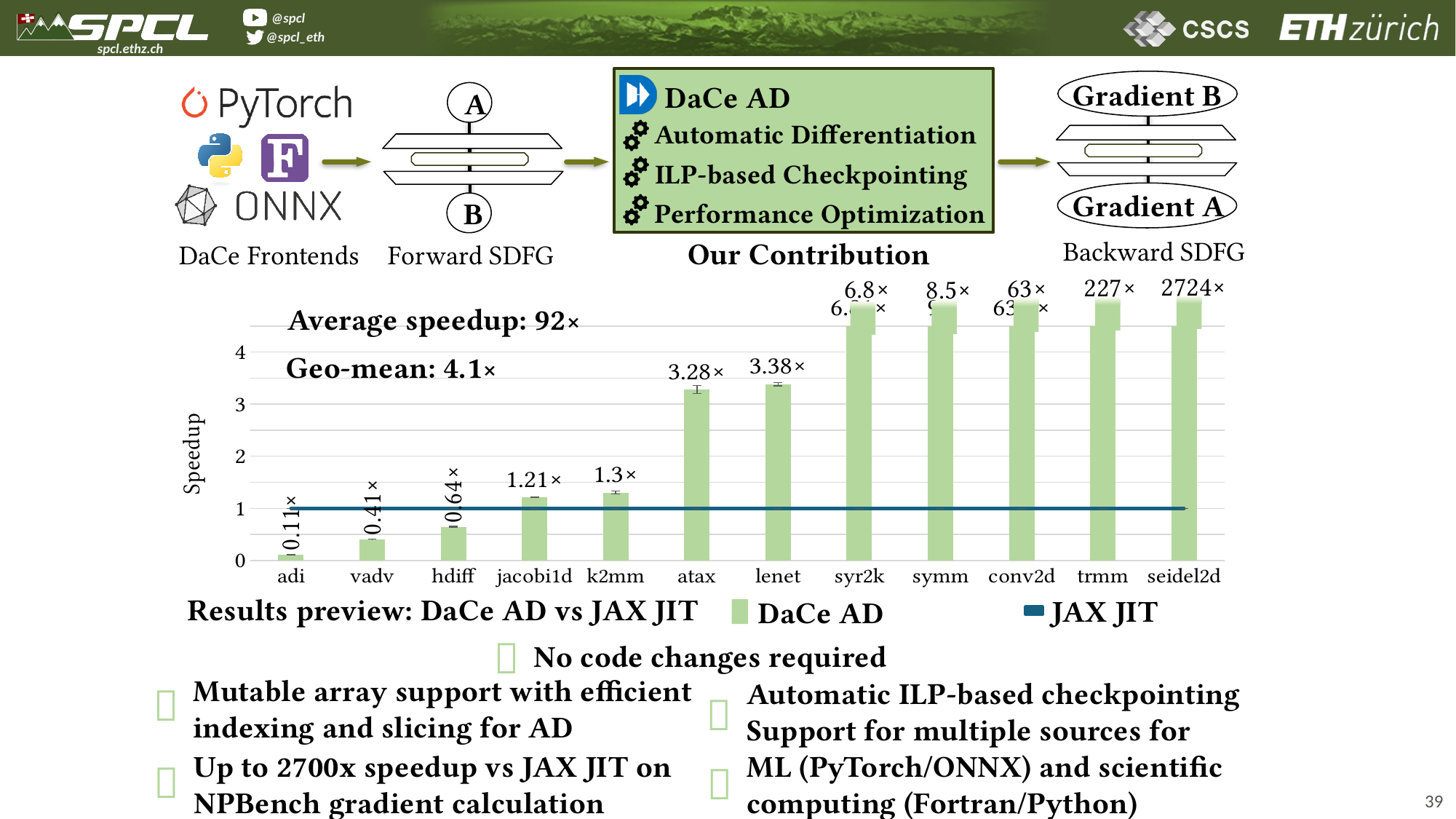
Which benchmark has the lowest DaCe AD speedup? adi How many series does the chart legend list? 2 How many benchmarks are shown on the x axis of the chart? 12 What is the speedup value shown for jacobi1d? 1.21× What kind of chart is used to show the speedup results? bar chart What average speedup is stated on the chart? 92× Which has a larger speedup, trmm or conv2d? trmm What is the speedup value shown for atax? 3.28× Which benchmark has the highest DaCe AD speedup? seidel2d What is the speedup value shown for lenet? 3.38× Is the speedup for hdiff greater or less than 1? less What is the speedup value shown for seidel2d? 2724×